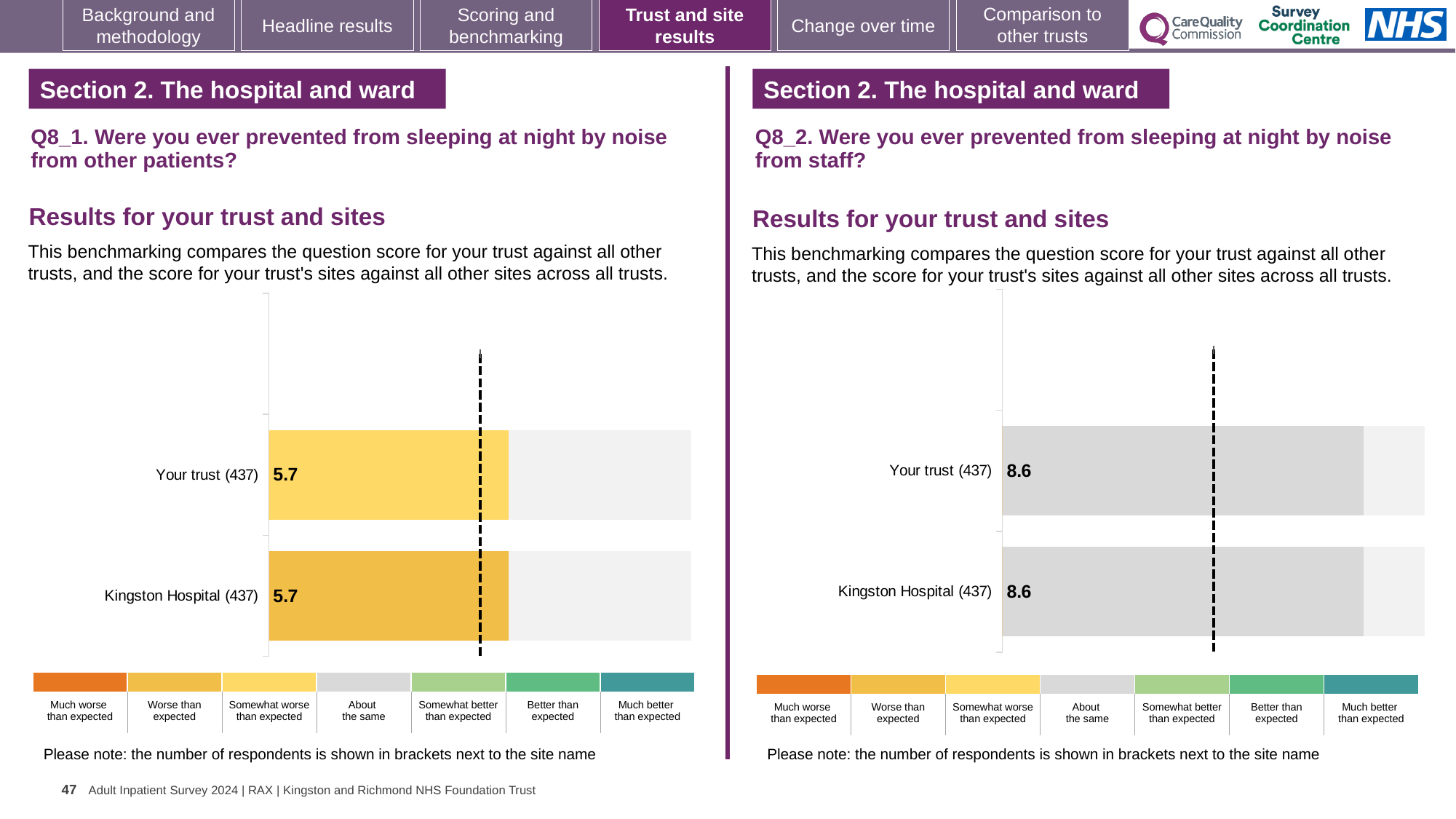
In the Q8_2 chart on the right, what is the difference between the scores for Your trust and Kingston Hospital? 0.0 How many bars are plotted in the Q8_2 chart on the right? 2 In the Q8_1 chart on the left, what is the score for Kingston Hospital (437)? 5.7 What type of chart is used for the Q8_1 results on the left? Bar chart In the Q8_1 chart on the left, which benchmark category does the colour of the Kingston Hospital bar correspond to in the legend? Worse than expected How many bars are plotted in the Q8_1 chart on the left? 2 In the Q8_1 chart on the left, how many respondents are shown in brackets for Kingston Hospital? 437 In the Q8_2 chart on the right, what is the score for Your trust (437)? 8.6 In the Q8_1 chart on the left, what is the difference between the scores for Your trust and Kingston Hospital? 0.0 In the Q8_2 chart on the right, which benchmark category does the grey colour of the bars correspond to in the legend? About the same In the Q8_1 chart on the left, what is the score for Your trust (437)? 5.7 In the Q8_2 chart on the right, what is the score for Kingston Hospital (437)? 8.6